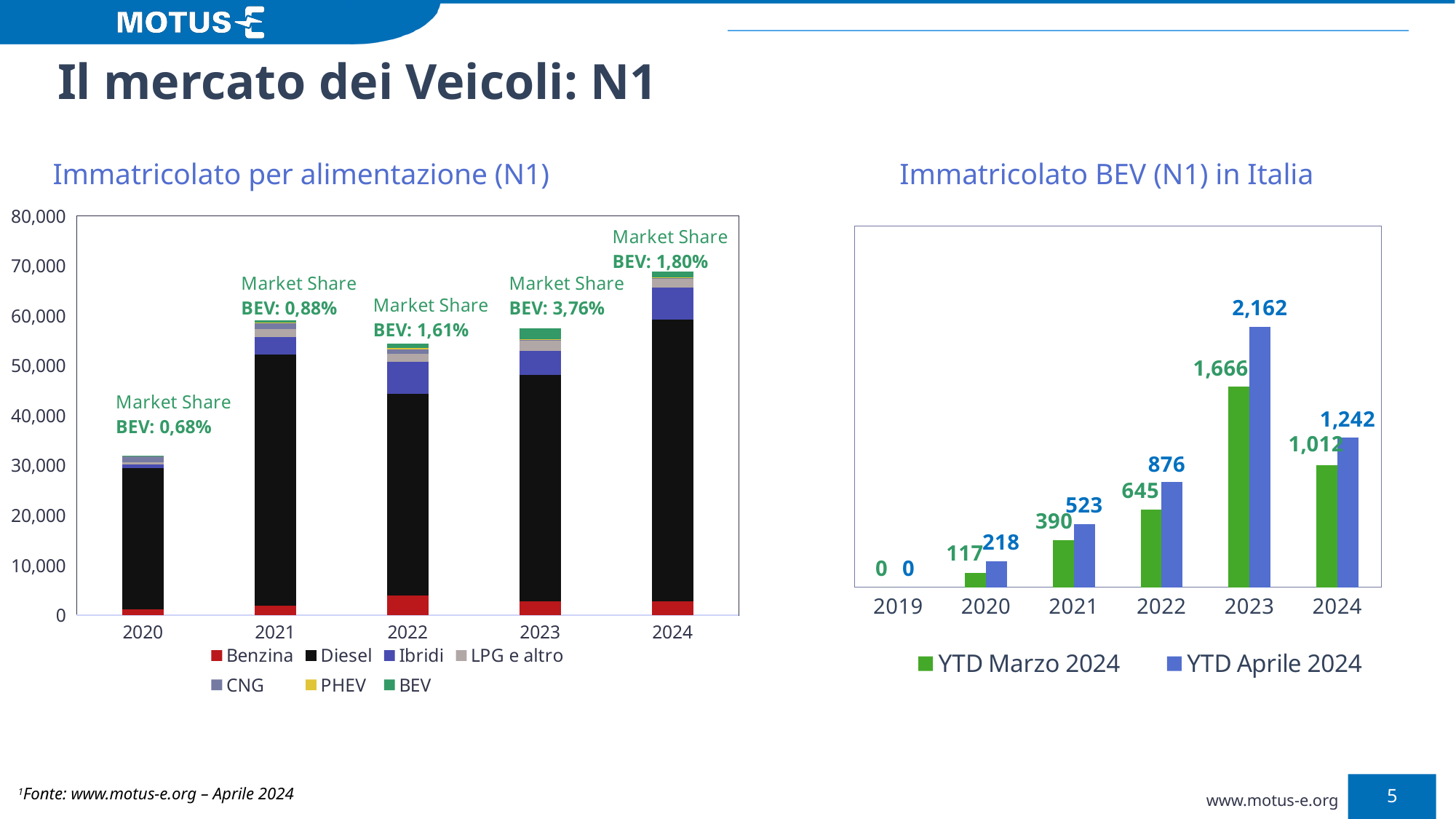
In the chart 'Immatricolato per alimentazione (N1)', what is the BEV market share shown for 2023? 3,76% In the chart 'Immatricolato BEV (N1) in Italia', which year has the highest YTD Aprile 2024 value? 2023 In the chart 'Immatricolato BEV (N1) in Italia', what is the value for YTD Aprile 2024 in 2023? 2,162 What kind of chart is 'Immatricolato per alimentazione (N1)'? Stacked bar chart In the chart 'Immatricolato BEV (N1) in Italia', how many series does the legend list? 2 In the chart 'Immatricolato BEV (N1) in Italia', what is the value for YTD Marzo 2024 in 2022? 645 In the chart 'Immatricolato BEV (N1) in Italia', how many years are shown on the x axis? 6 In the chart 'Immatricolato per alimentazione (N1)', is the total stacked bar for 2020 greater or less than 40,000? less In the chart 'Immatricolato BEV (N1) in Italia', what is the difference between the YTD Aprile 2024 and YTD Marzo 2024 values in 2024? 230 In the chart 'Immatricolato per alimentazione (N1)', how many series does the legend list? 7 In the chart 'Immatricolato per alimentazione (N1)', which year has the highest BEV market share annotation? 2023 In the chart 'Immatricolato BEV (N1) in Italia', which is larger: the YTD Marzo 2024 value in 2021 or the YTD Aprile 2024 value in 2020? YTD Marzo 2024 in 2021